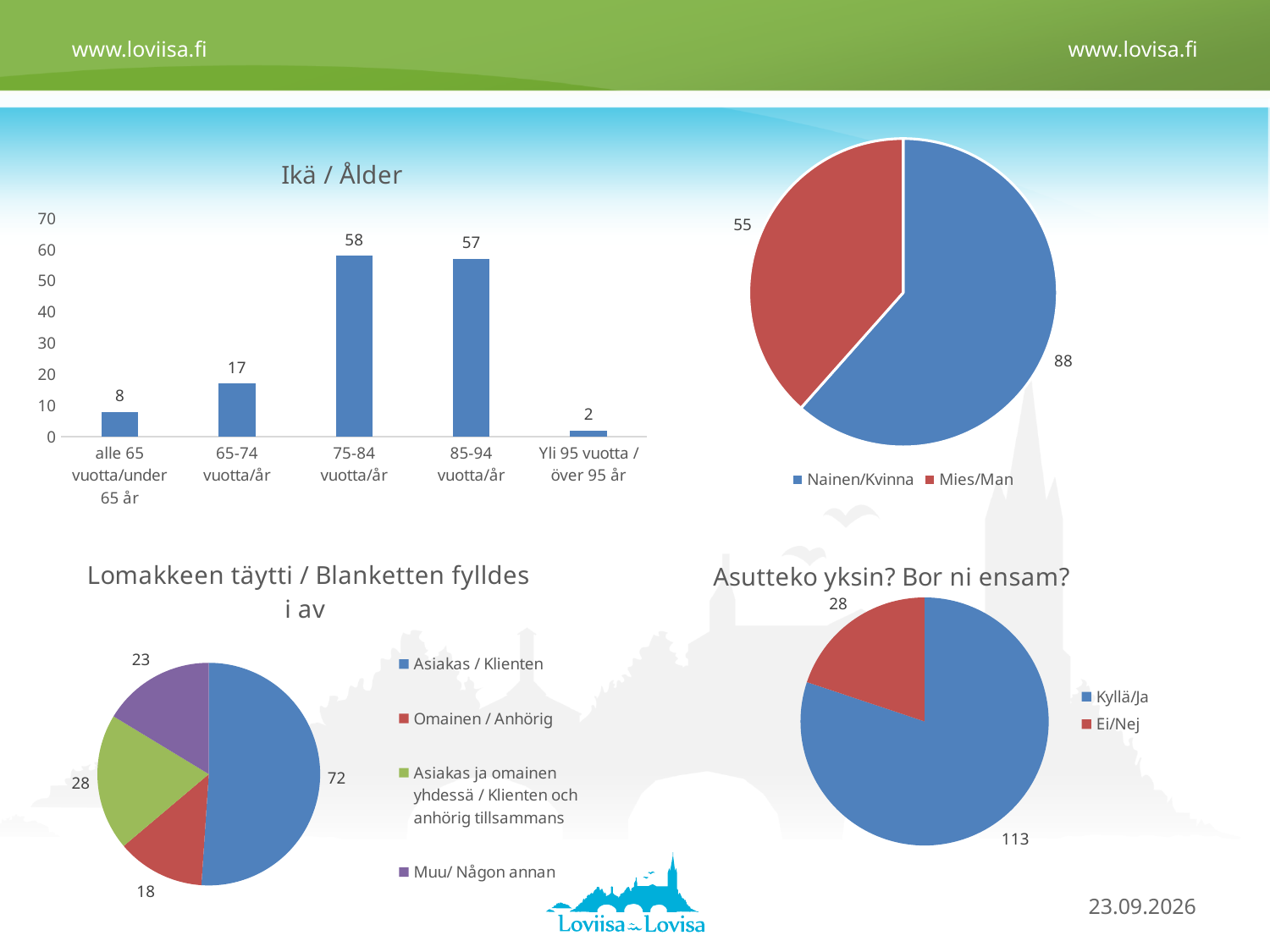
In the 'Ikä / Ålder' chart, how many age categories are shown? 5 In the 'Ikä / Ålder' chart, what is the value for 75-84 vuotta/år? 58 In the 'Lomakkeen täytti / Blanketten fylldes i av' chart, what is the total of all slices? 141 In the pie chart at the top right of the slide, what is the value for Mies/Man? 55 In the 'Ikä / Ålder' chart, what is the difference between the values for 65-74 vuotta/år and alle 65 vuotta/under 65 år? 9 In the 'Asutteko yksin? Bor ni ensam?' chart, what is the value for Kyllä/Ja? 113 In the 'Asutteko yksin? Bor ni ensam?' chart, what is the difference between Kyllä/Ja and Ei/Nej? 85 What kind of chart is 'Ikä / Ålder'? bar chart In the pie chart at the top right of the slide, which is larger, Nainen/Kvinna or Mies/Man? Nainen/Kvinna In the 'Lomakkeen täytti / Blanketten fylldes i av' chart, what is the value for Asiakas ja omainen yhdessä / Klienten och anhörig tillsammans? 28 How many entries does the legend of the 'Lomakkeen täytti / Blanketten fylldes i av' chart list? 4 In the 'Ikä / Ålder' chart, which age category has the lowest value? Yli 95 vuotta / över 95 år